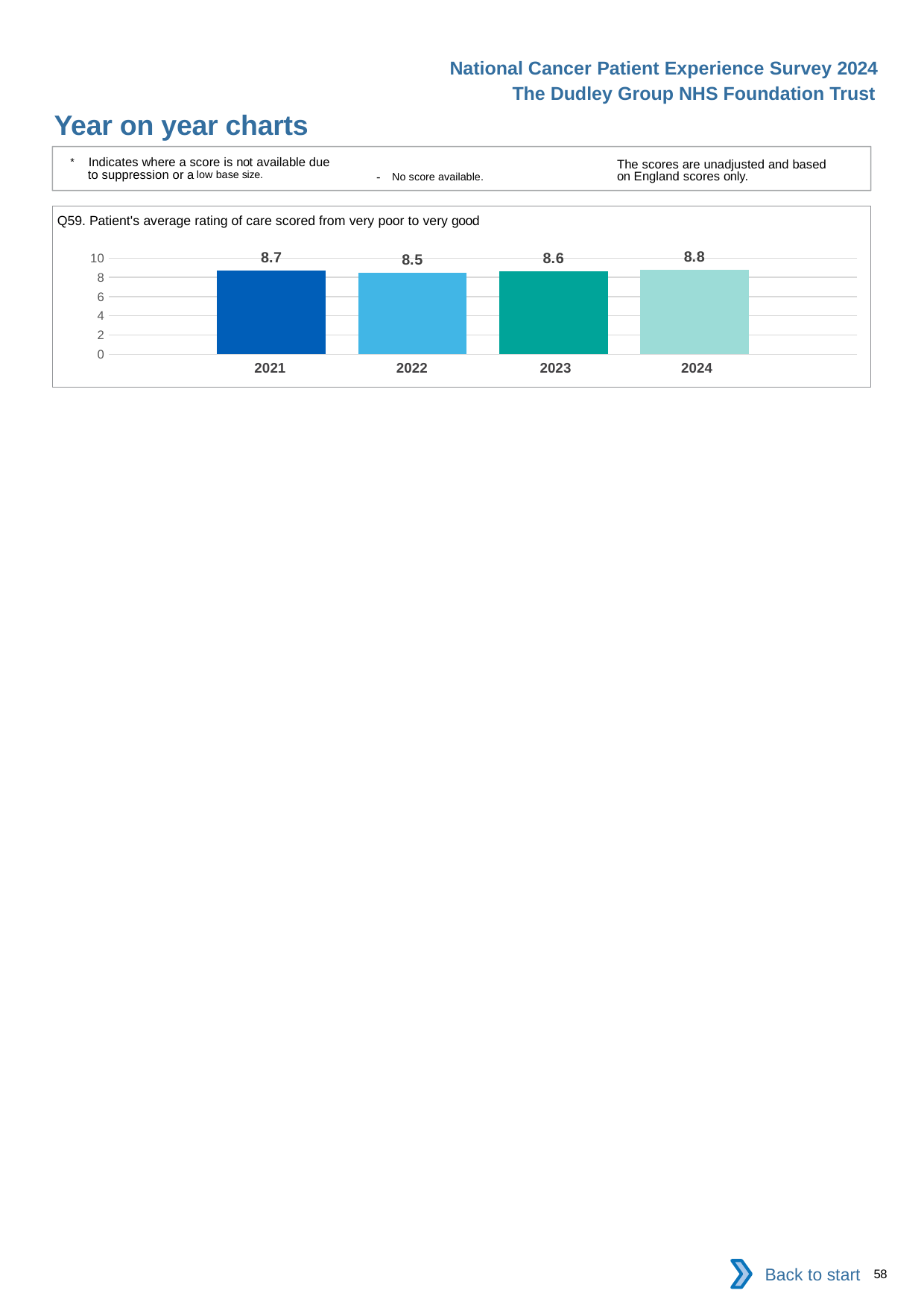
What is the value for 2021? 8.7 Which year has the highest value? 2024 What kind of chart is shown? bar chart Which is larger, the value for 2021 or the value for 2023? 2021 Which year has the lowest value? 2022 What is the title of the chart? Q59. Patient's average rating of care scored from very poor to very good Is the value for 2022 greater or less than 8? greater How many years are shown on the chart? 4 What is the value for 2023? 8.6 What is the value for 2024? 8.8 What is the difference between the values for 2024 and 2022? 0.3 What is the value for 2022? 8.5